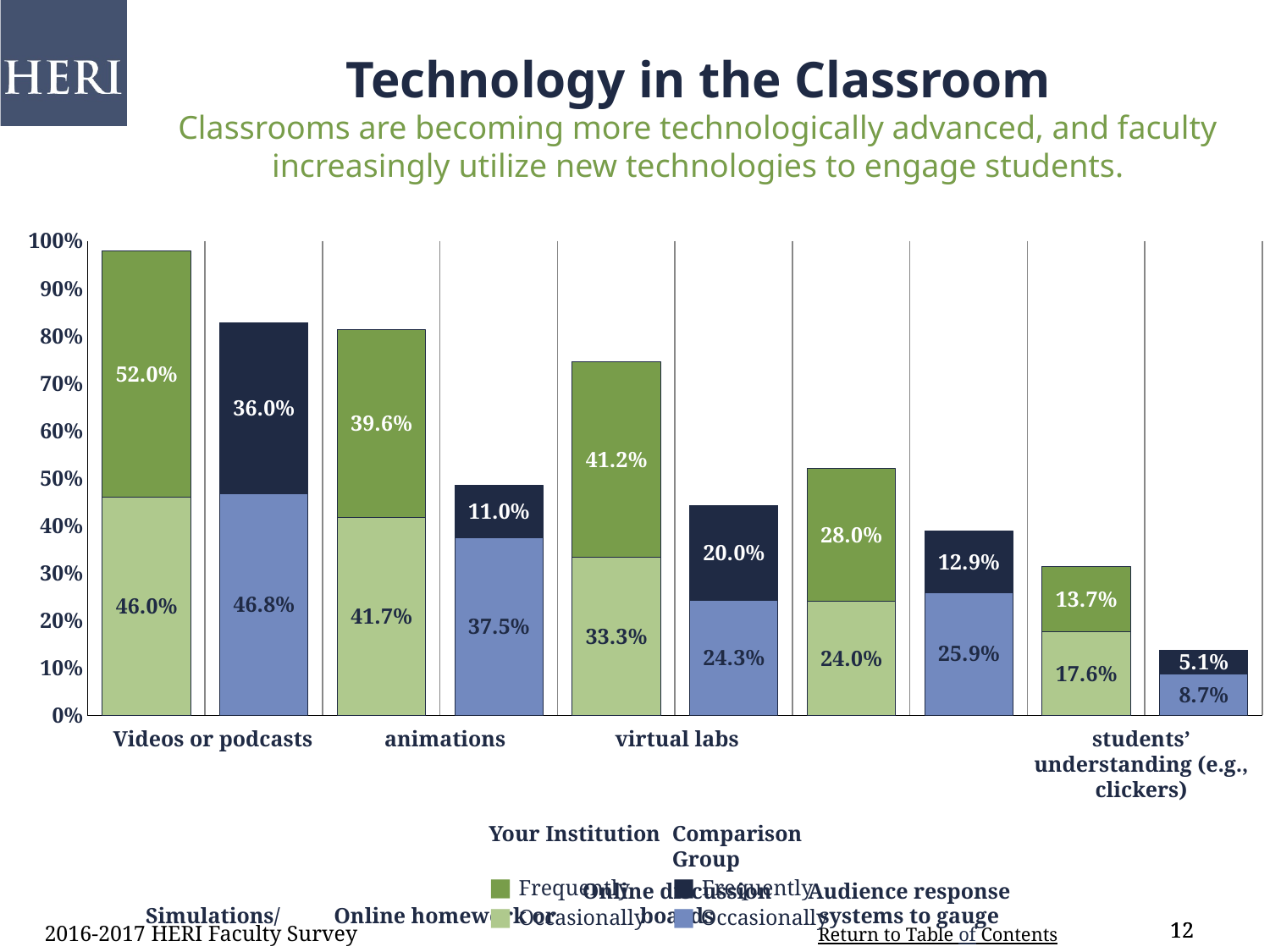
What is the total of the Comparison Group stacked bar for audience response systems (e.g., clickers)? 13.8% Which category has the highest Your Institution 'Frequently' value? Videos or podcasts What is the total of the Comparison Group stacked bar for videos or podcasts? 82.8% What is the difference between the Your Institution and Comparison Group 'Frequently' values for videos or podcasts? 16.0% What percentage of Your Institution faculty use videos or podcasts frequently? 52.0% What is the total of the Your Institution stacked bar for videos or podcasts? 98.0% Which is larger for virtual labs: the Your Institution 'Occasionally' value or the Comparison Group 'Occasionally' value? Your Institution (33.3%) What kind of chart is shown on the slide? stacked bar chart What percentage of Comparison Group faculty use videos or podcasts occasionally? 46.8% What percentage of Comparison Group faculty use audience response systems (e.g., clickers) frequently? 5.1% How many series does the legend list? 4 What percentage of Your Institution faculty use virtual labs frequently? 41.2%